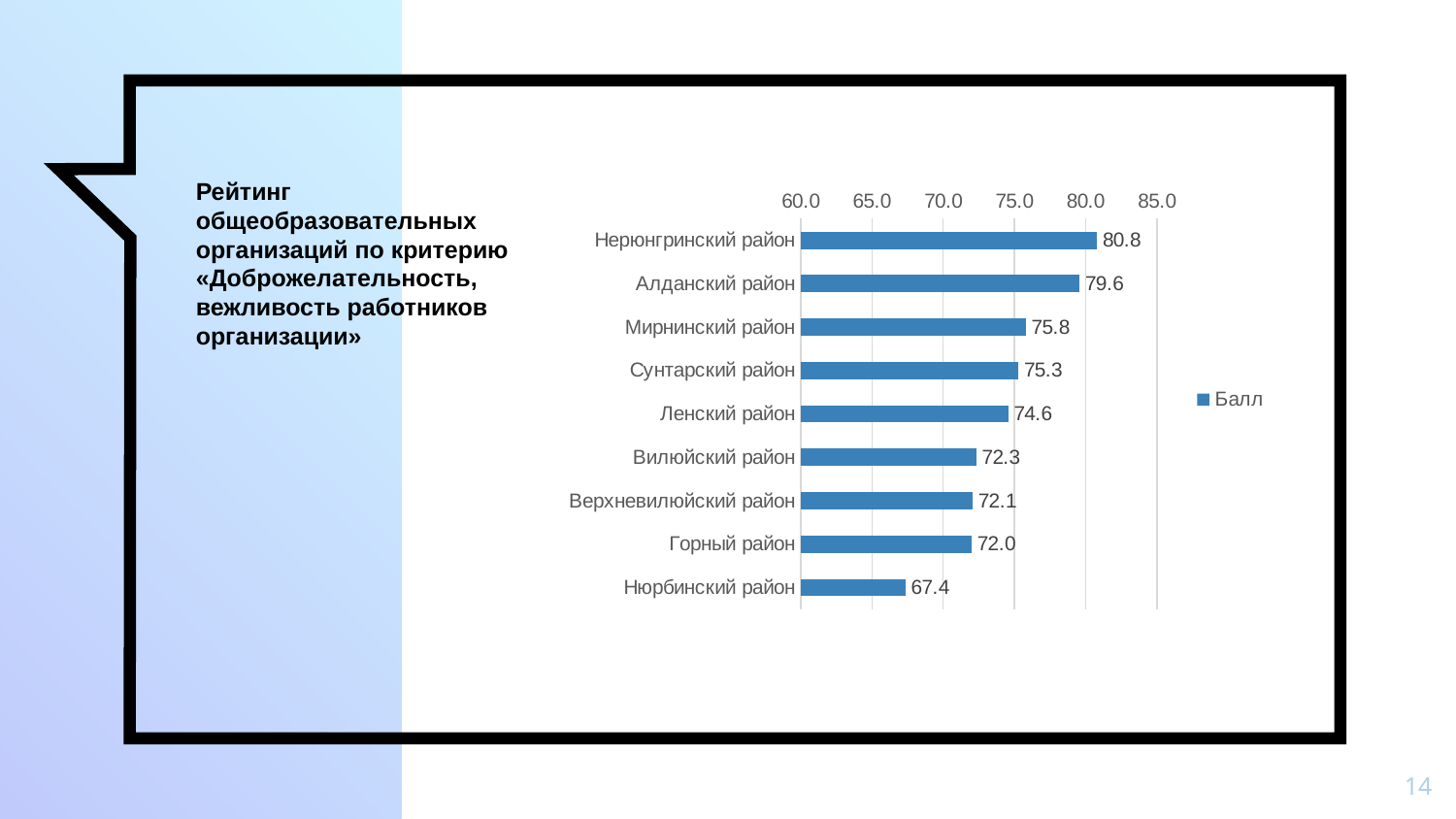
How many series does the legend list? 1 Which district has the lowest value? Нюрбинский район What is the difference between the values for Нерюнгринский район and Алданский район? 1.2 Which is larger, the value for Сунтарский район or the value for Вилюйский район? Сунтарский район What is the value for Нюрбинский район? 67.4 How many districts are shown in the chart? 9 What is the value for Ленский район? 74.6 What is the difference between the values for Мирнинский район and Нюрбинский район? 8.4 What is the value for Нерюнгринский район? 80.8 Is the value for Алданский район greater or less than 75.0? greater What kind of chart is shown on the slide? Bar chart Which district has the highest value? Нерюнгринский район